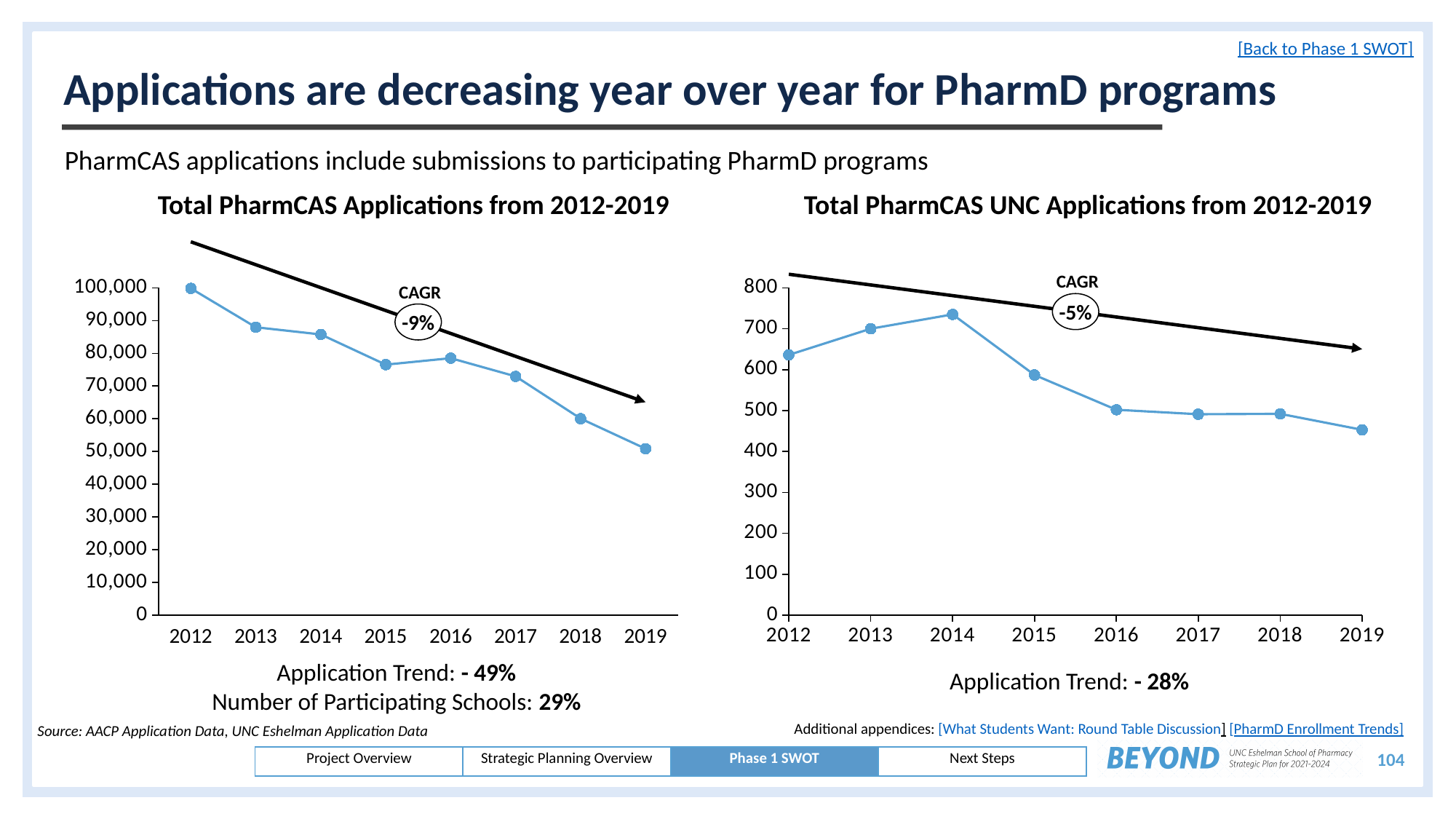
In the 'Total PharmCAS Applications from 2012-2019' chart, which year has the lowest value? 2019 What CAGR is shown on the 'Total PharmCAS UNC Applications from 2012-2019' chart? -5% In the 'Total PharmCAS UNC Applications from 2012-2019' chart, which is larger, the value for 2013 or the value for 2015? 2013 In the 'Total PharmCAS UNC Applications from 2012-2019' chart, is the value for 2015 greater or less than 500? greater What type of chart is the 'Total PharmCAS Applications from 2012-2019' chart? line chart In the 'Total PharmCAS UNC Applications from 2012-2019' chart, which year has the highest value? 2014 In the 'Total PharmCAS Applications from 2012-2019' chart, do the values generally rise or fall from 2012 to 2019? fall In the 'Total PharmCAS Applications from 2012-2019' chart, which year has the highest value? 2012 In the 'Total PharmCAS Applications from 2012-2019' chart, is the value for 2019 greater or less than 60,000? less In the 'Total PharmCAS Applications from 2012-2019' chart, how many years are plotted? 8 In the 'Total PharmCAS Applications from 2012-2019' chart, is the value for 2013 greater or less than 80,000? greater In the 'Total PharmCAS UNC Applications from 2012-2019' chart, which year has the lowest value? 2019